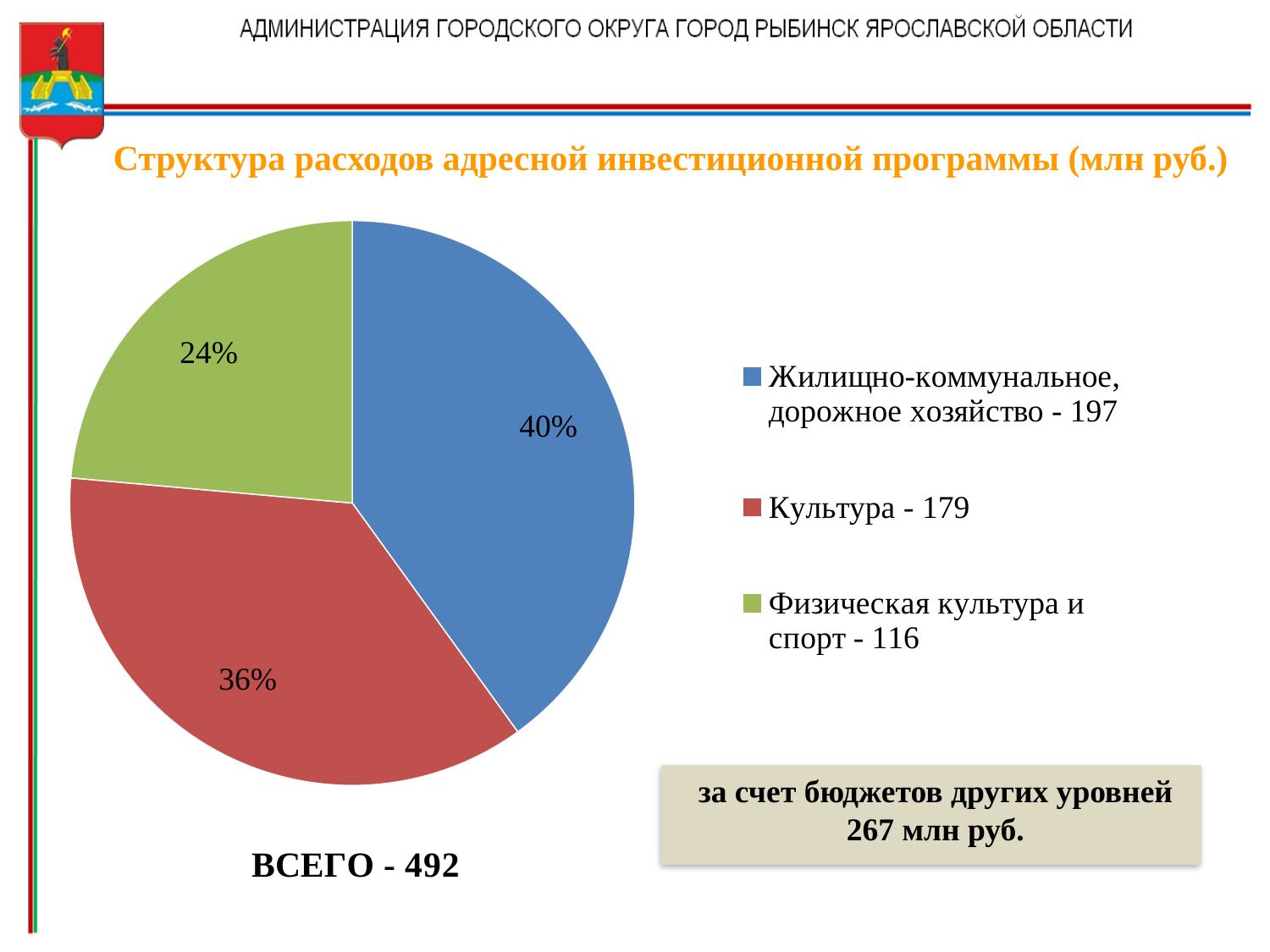
What share of the pie does the slice for Культура take? 36% What share of the pie does the slice for Физическая культура и спорт take? 24% What colour is the slice for Физическая культура и спорт? green What value (млн руб.) is given in the legend for Культура? 179 Which category has the largest slice of the pie? Жилищно-коммунальное, дорожное хозяйство Which slice is larger: Культура or Физическая культура и спорт? Культура Which category has the smallest slice of the pie? Физическая культура и спорт What share of the pie does the slice for Жилищно-коммунальное, дорожное хозяйство take? 40% What kind of chart is shown on the slide? pie chart What is the difference in percentage points between the Культура slice and the Физическая культура и спорт slice? 12% How many entries does the legend list? 3 How many slices does the pie chart have? 3